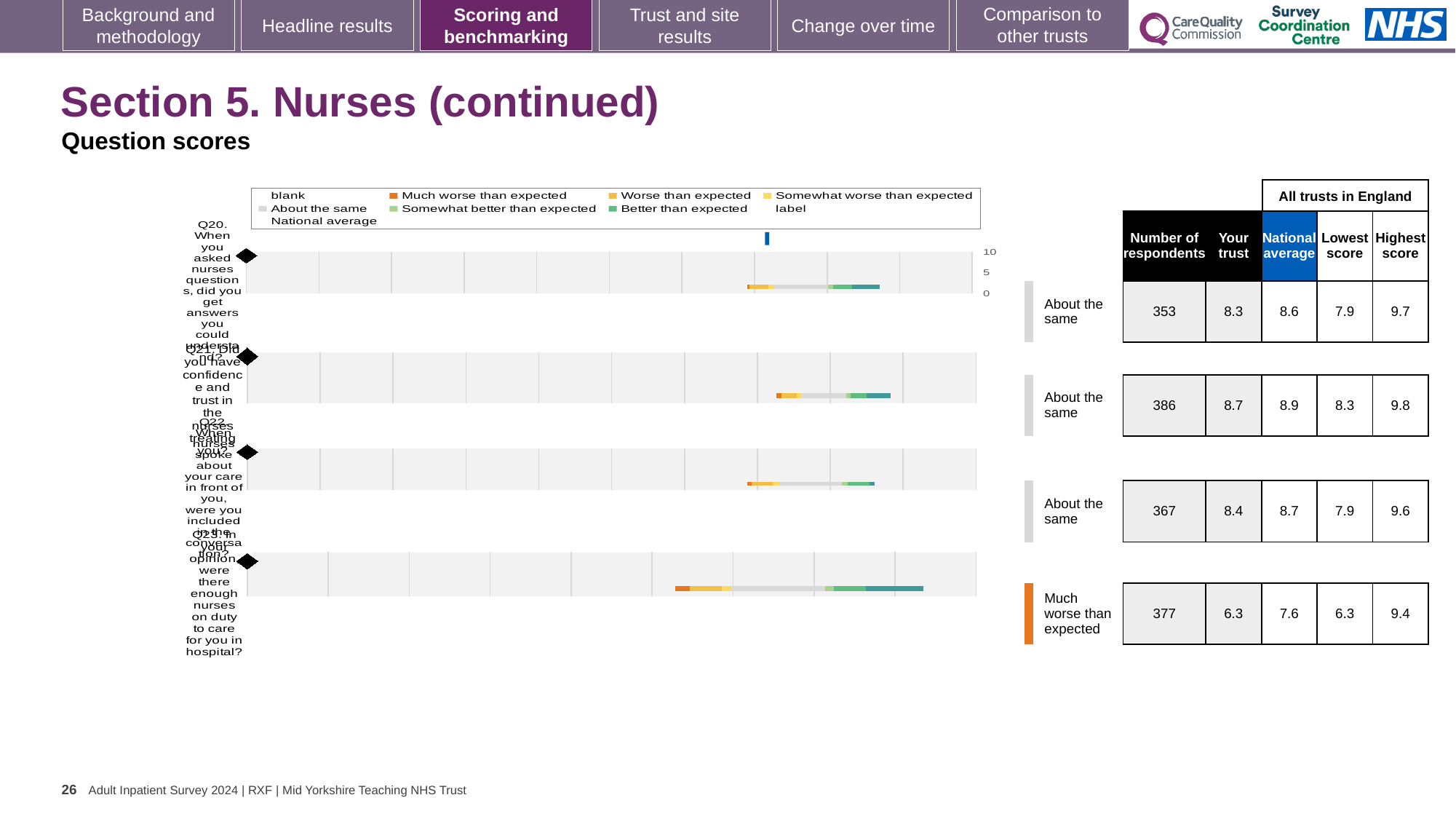
What kind of chart is used to show the question scores for Q20 to Q23? Bar chart For Q20 (did you get answers you could understand), what is the 'Your trust' score shown in the table? 8.3 What benchmark category is shown for Q23 (were there enough nurses on duty)? Much worse than expected What is the lowest score across all trusts in England for Q20? 7.9 Which question has the highest 'Your trust' score? Q21 For Q23, what is the difference between the national average and the 'Your trust' score? 1.3 Which has the larger 'Your trust' score, Q21 or Q22? Q21 What is the highest score across all trusts in England for Q22 (included in the conversation)? 9.6 How many respondents are listed for Q21 (confidence and trust in the nurses)? 386 How many questions (Q20 to Q23) are charted on the slide? 4 Which question has the lowest 'Your trust' score? Q23 For Q23 (were there enough nurses on duty), what is the national average score? 7.6